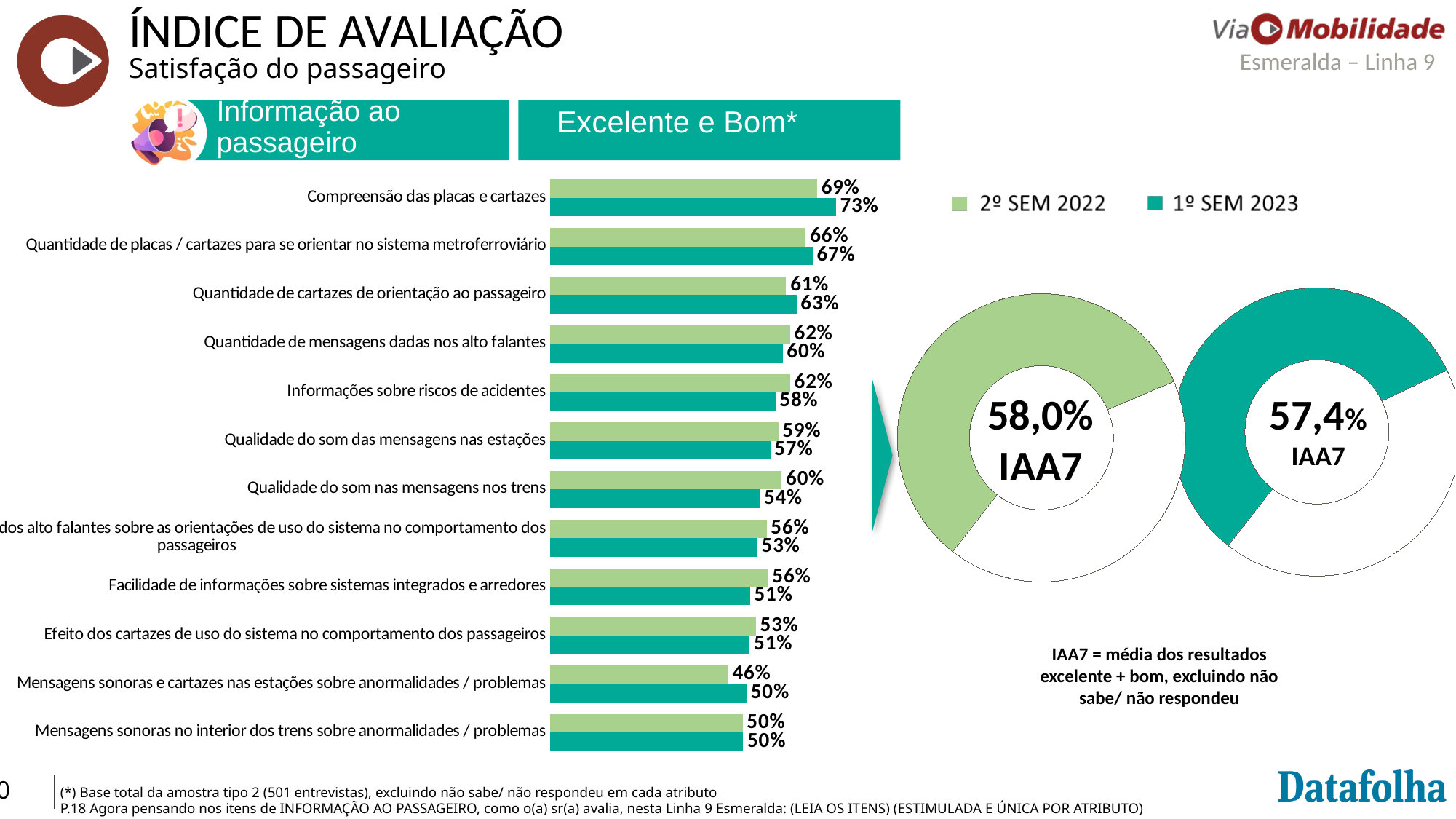
In the left donut chart (2º SEM 2022), what IAA7 value is shown in the centre? 58,0% In the bar chart, what is the 1º SEM 2023 value for 'Facilidade de informações sobre sistemas integrados e arredores'? 51% In the bar chart, what is the 2º SEM 2022 value for 'Qualidade do som nas mensagens nos trens'? 60% What type of chart is the 'Excelente e Bom*' chart? Bar chart In the bar chart, which category has the lowest 2º SEM 2022 value? Mensagens sonoras e cartazes nas estações sobre anormalidades / problemas In the bar chart, which category has the highest 1º SEM 2023 value? Compreensão das placas e cartazes How many categories does the bar chart show? 12 In the bar chart, what is the 1º SEM 2023 value for 'Compreensão das placas e cartazes'? 73% In the right donut chart (1º SEM 2023), what IAA7 value is shown in the centre? 57,4% How many series does the bar chart legend list? 2 In the bar chart, what is the difference between the 2º SEM 2022 and 1º SEM 2023 values for 'Qualidade do som nas mensagens nos trens'? 6% In the bar chart, for 'Mensagens sonoras e cartazes nas estações sobre anormalidades / problemas', which is larger: the 2º SEM 2022 value or the 1º SEM 2023 value? 1º SEM 2023